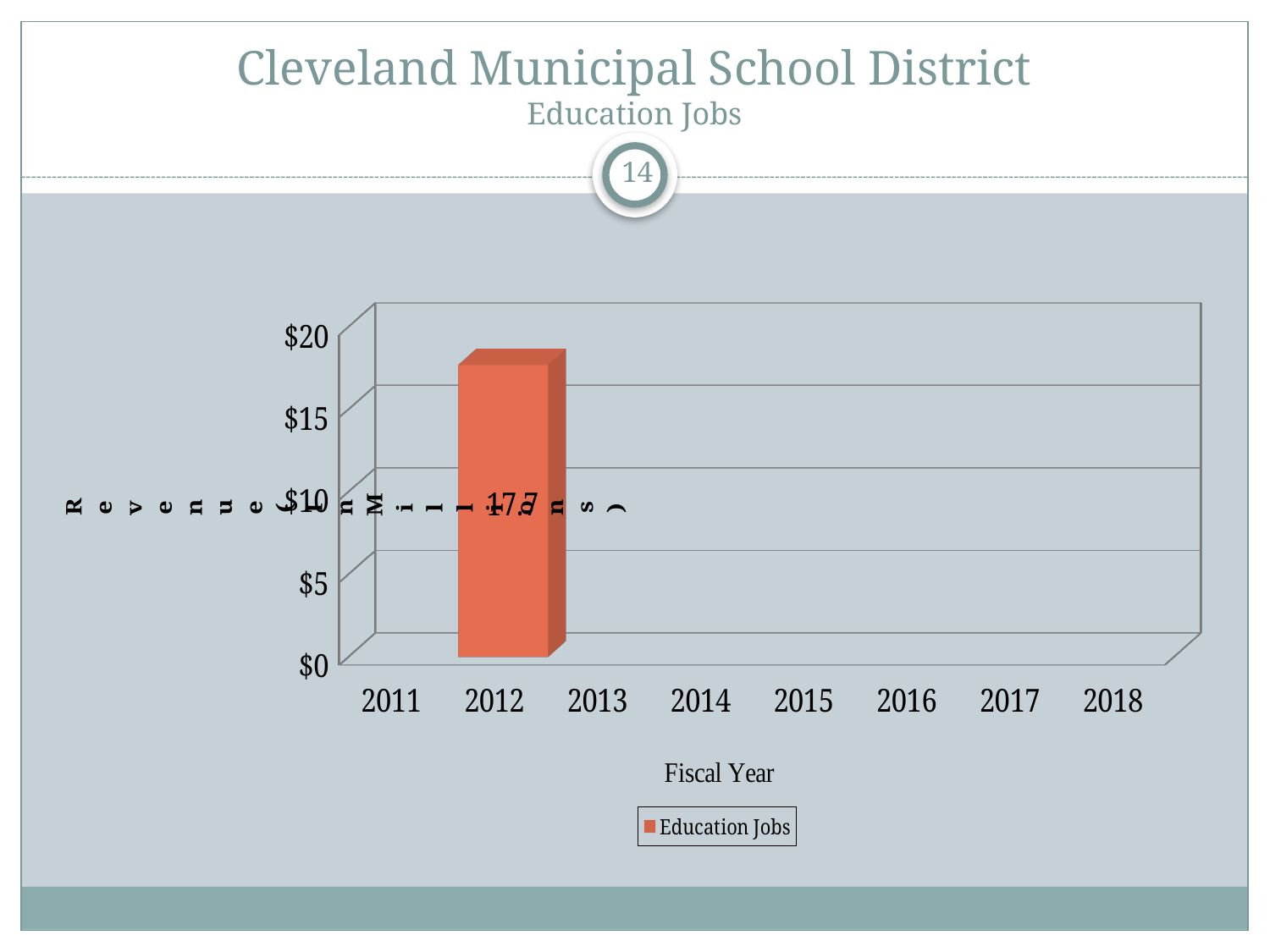
Which fiscal year has the highest Education Jobs value in the chart? 2012 What type of chart is shown on the slide? Bar chart What is the Education Jobs value labelled on the bar for fiscal year 2012? 17.7 Which fiscal year is the only one with a visible bar in the chart? 2012 What is the name of the series shown in the chart legend? Education Jobs How many fiscal years are shown on the x axis of the chart? 8 How many series does the chart legend list? 1 What is the title of the x axis of the chart? Fiscal Year Is the Education Jobs value for 2012 greater or less than $20? less What is the highest value shown on the y axis of the chart? $20 Is the Education Jobs value for 2012 greater or less than $15? greater